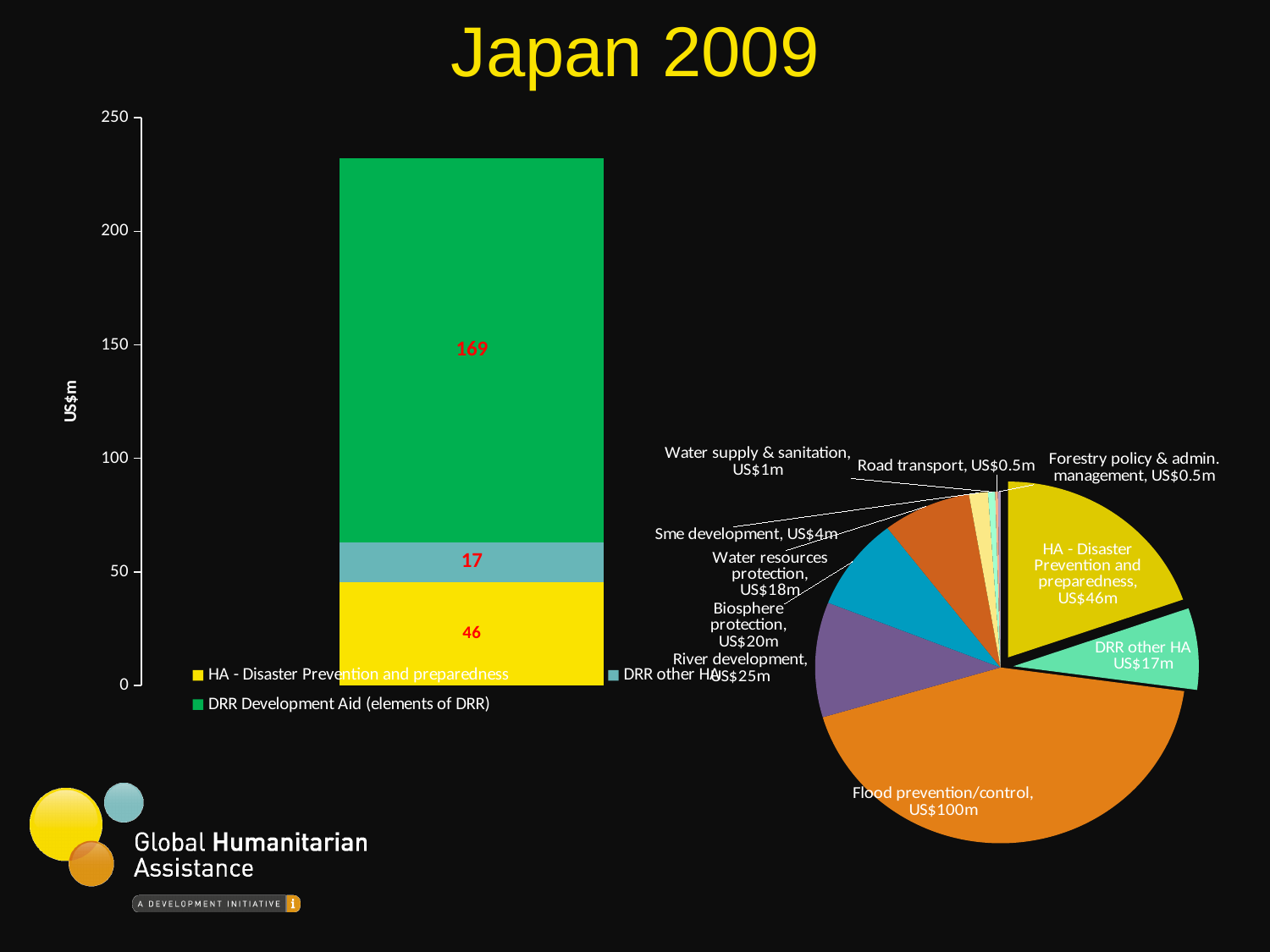
In the stacked bar chart on the left, what is the value for DRR Development Aid (elements of DRR)? 169 In the pie chart on the right, which is larger: Biosphere protection or Water resources protection? Biosphere protection In the stacked bar chart on the left, what is the value for DRR other HA? 17 What kind of chart is the chart on the left of the slide? Bar chart In the pie chart on the right, what is the value for River development? US$25m In the pie chart on the right, what is the value for Flood prevention/control? US$100m In the stacked bar chart on the left, which segment has the largest value? DRR Development Aid (elements of DRR) In the stacked bar chart on the left, what is the total of the stacked bar? 232 In the stacked bar chart on the left, what is the difference between the DRR Development Aid (elements of DRR) value and the HA - Disaster Prevention and preparedness value? 123 How many slices does the pie chart on the right have? 10 How many series does the legend of the stacked bar chart on the left list? 3 What kind of chart is the chart on the right of the slide? Pie chart